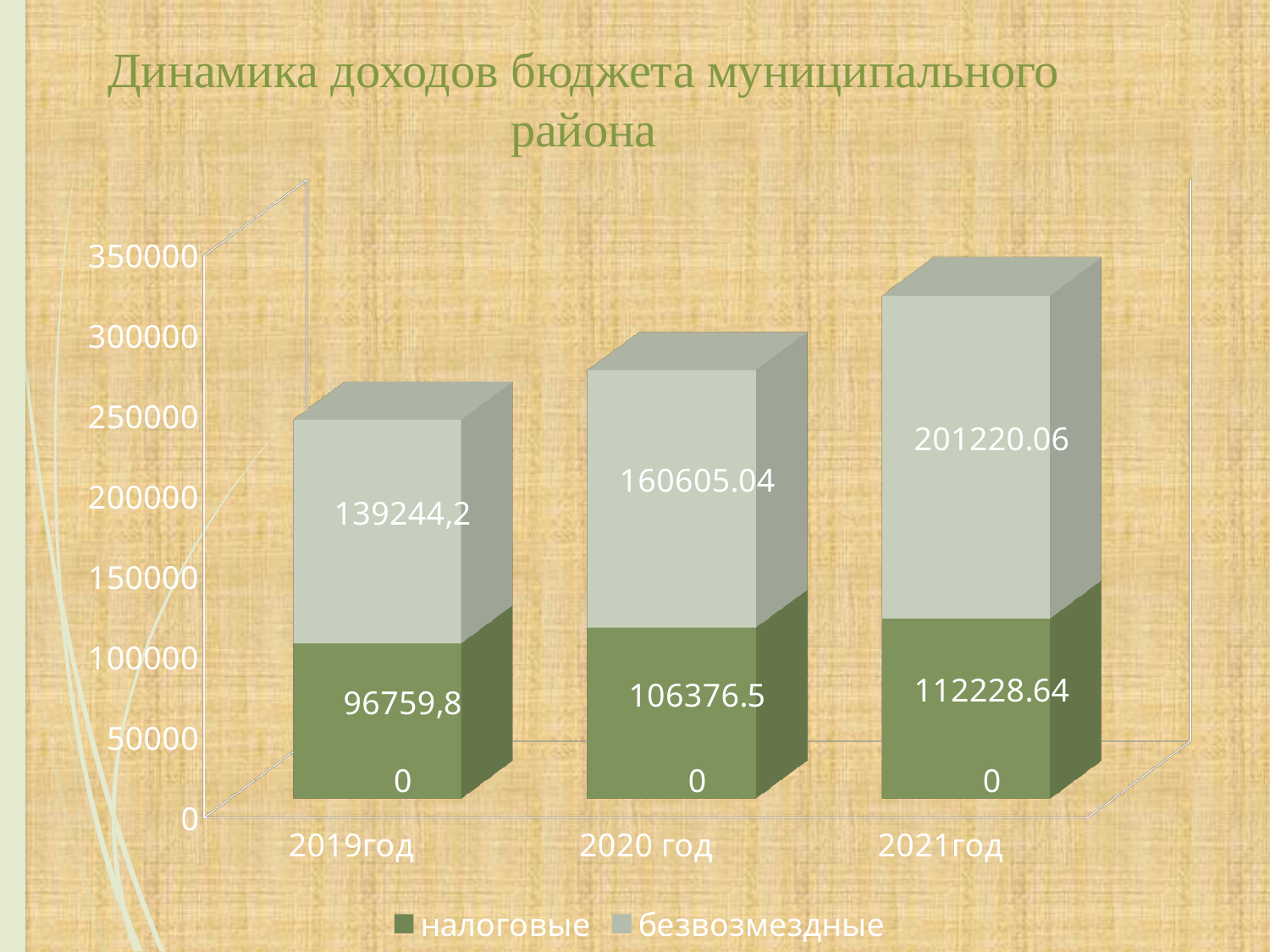
In which year is the налоговые value the lowest? 2019год How much larger is безвозмездные in 2021год than in 2020 год? 40615.02 How many years are shown on the x axis? 3 Do the безвозмездные values rise or fall from 2019год to 2021год? rise How many series does the legend list? 2 What is the value of безвозмездные for 2021год? 201220.06 Which is larger for 2020 год: налоговые or безвозмездные? безвозмездные What is the value of налоговые for 2019год? 96759,8 What is the value of безвозмездные for 2020 год? 160605.04 What type of chart is shown on the slide? stacked bar chart In which year is the безвозмездные value the highest? 2021год What is the value of налоговые for 2021год? 112228.64